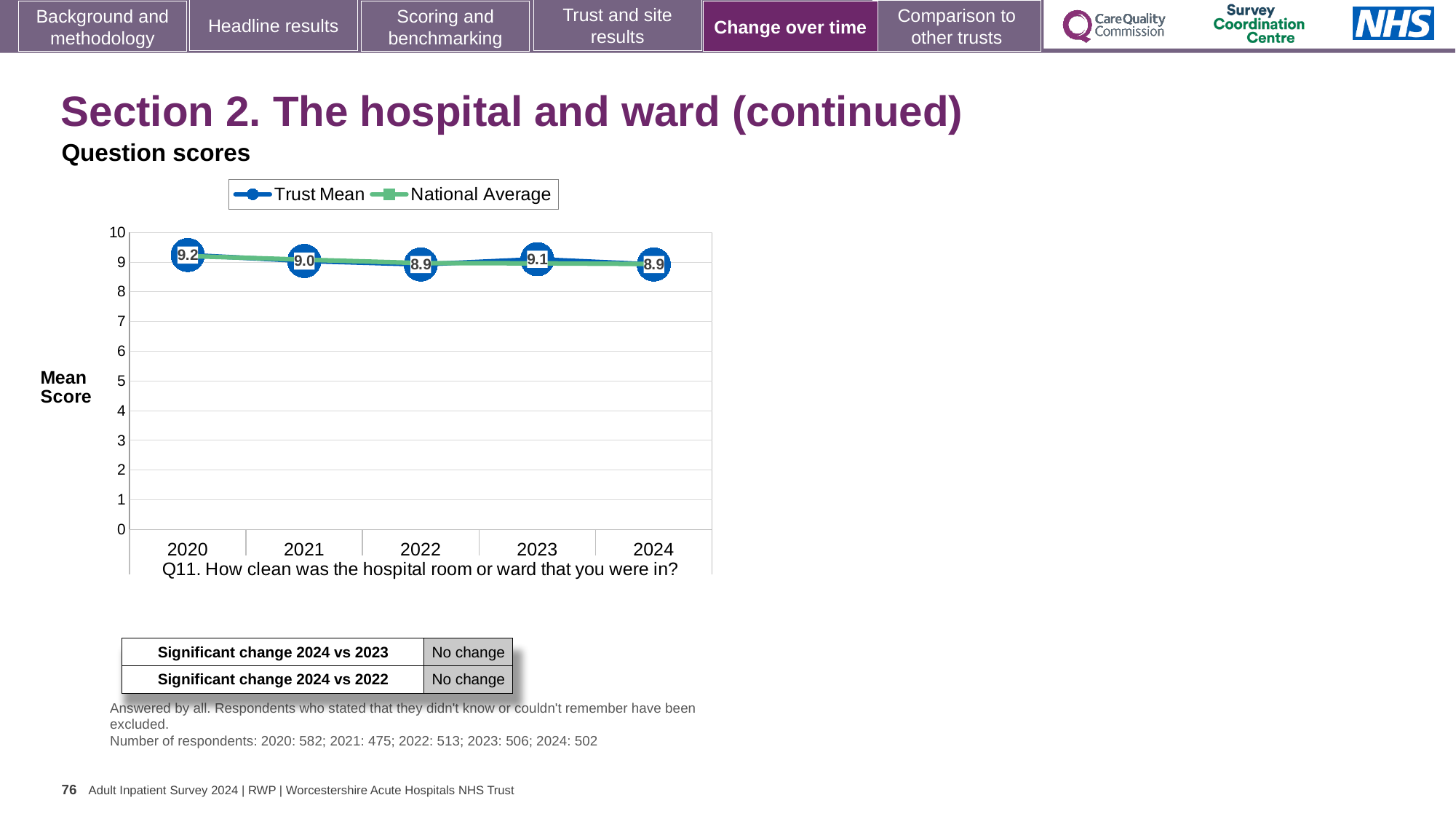
Is the Trust Mean score for 2022 greater or less than 5? greater How many series does the chart legend list? 2 What kind of chart is shown on the slide? Line chart What is the Trust Mean score for 2024? 8.9 How many years are shown on the x axis of the chart? 5 In which year is the Trust Mean score highest? 2020 Which question does the chart relate to? Q11. How clean was the hospital room or ward that you were in? Does the Trust Mean score rise or fall from 2020 to 2021? Fall What is the difference between the Trust Mean scores for 2020 and 2024? 0.3 What is the Trust Mean score for 2020? 9.2 What is the Trust Mean score for 2023? 9.1 Which is larger, the Trust Mean score for 2021 or for 2023? 2023